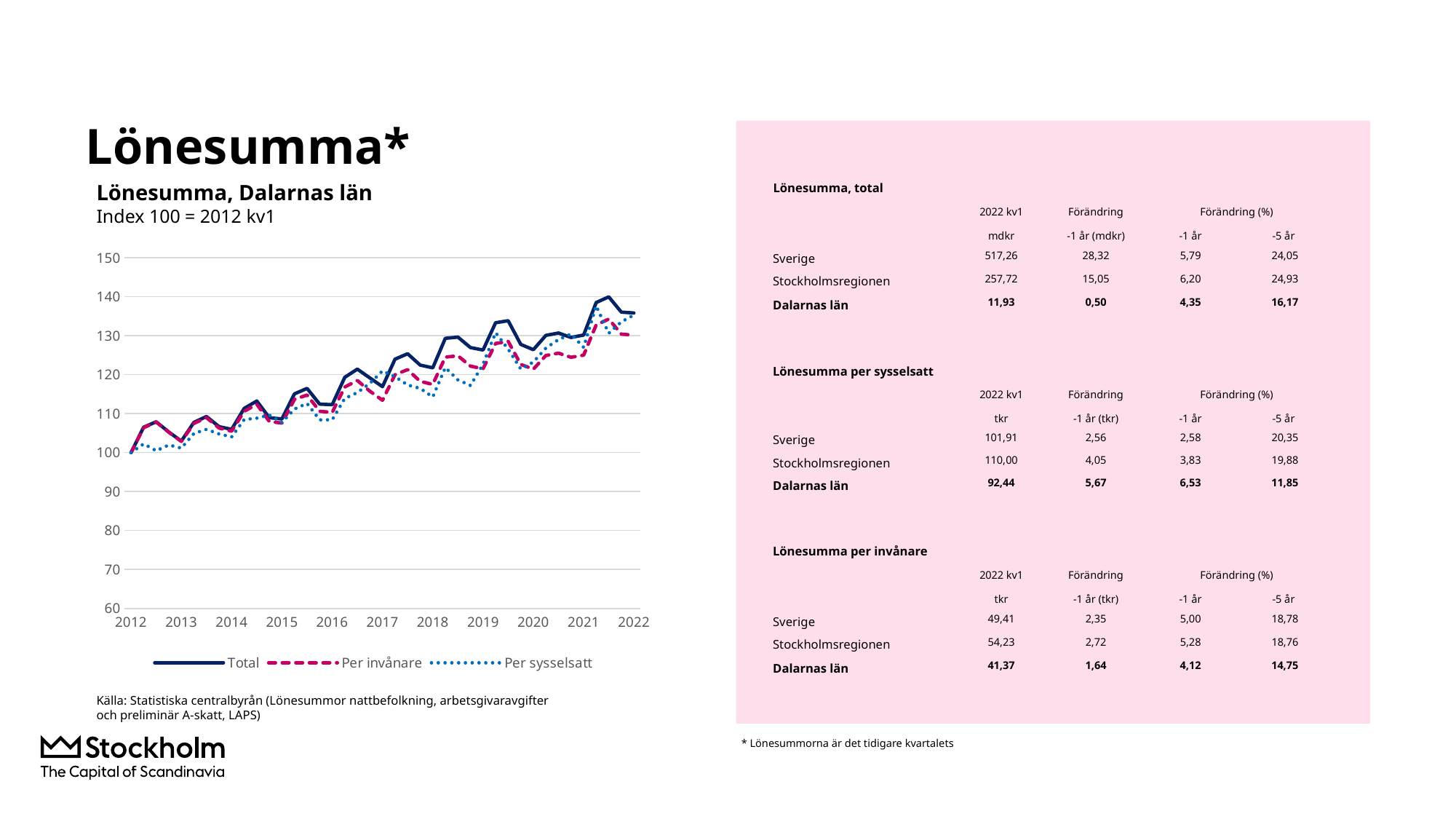
How many year labels are shown on the x axis of the chart? 11 What is the index value of the series at the start of the chart, 2012 kv1? 100 Do the values of the Total series generally rise or fall from 2012 to 2022? Rise What kind of chart is shown on the slide? Line chart Is the value of the Per sysselsatt series at 2018 greater or less than 120? less What is the title of the chart? Lönesumma, Dalarnas län Which series in the chart is drawn as a dotted line? Per sysselsatt How many series does the legend of the chart list? 3 At 2022, which is larger: the Total series or the Per invånare series? Total Is the highest value reached by the Total series greater or less than 130? greater Is the value of the Total series at 2016 greater or less than 120? less